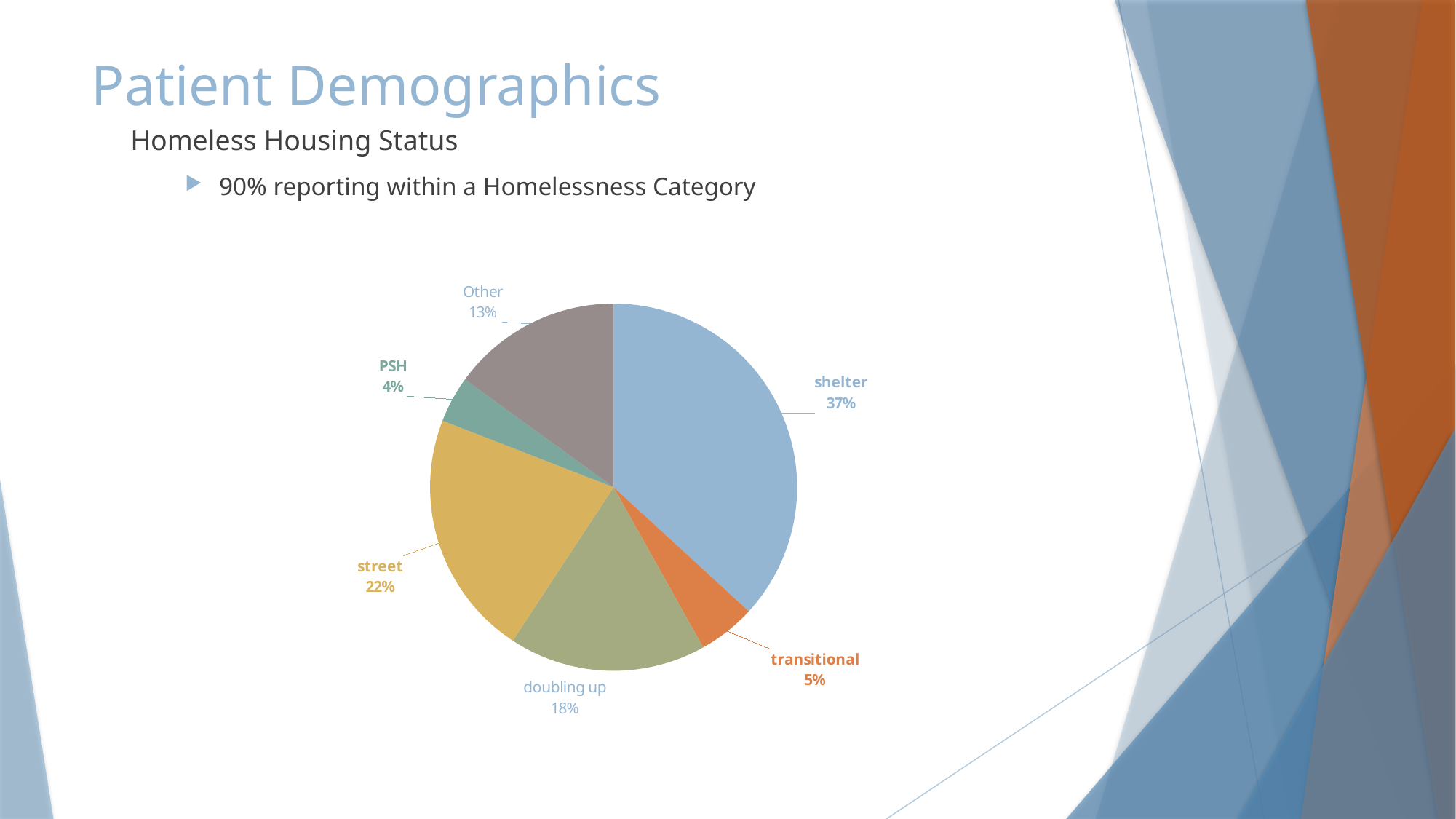
What percentage of the pie is the shelter slice? 37% Which category has the largest share of the pie? shelter What percentage is shown for doubling up? 18% What type of chart is shown on the slide? pie chart What is the combined percentage of the street and doubling up slices? 40% How many slices does the pie chart have? 6 What colour is the shelter slice of the pie? light blue What is the difference in percentage points between the shelter and street slices? 15 What percentage is shown for the PSH category? 4% Which category has the smallest share of the pie? PSH What percentage is shown for the street category? 22% Which is larger, the Other slice or the transitional slice? Other